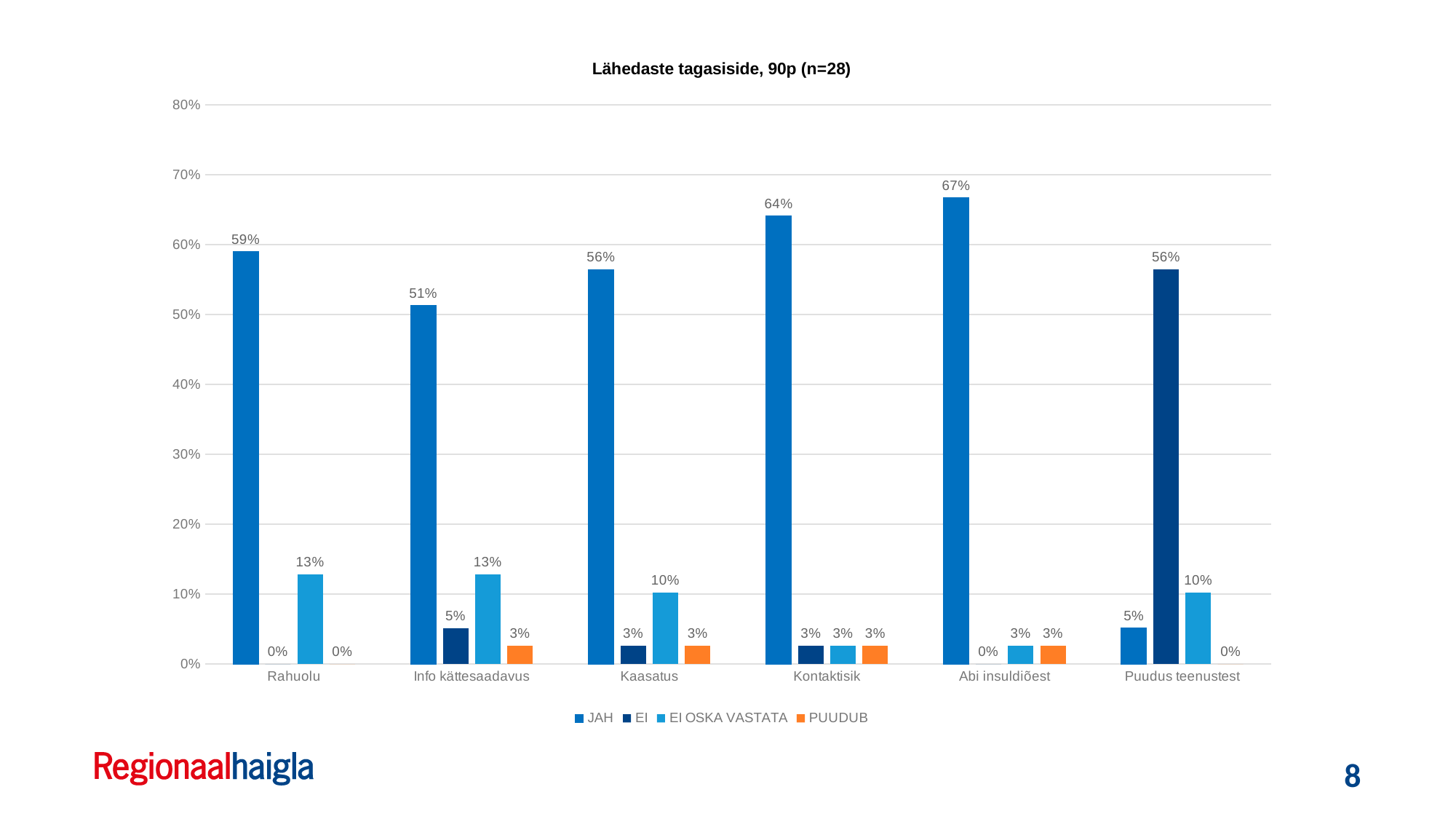
What is the title of the chart? Lähedaste tagasiside, 90p (n=28) What is the difference between the JAH values for Abi insuldiõest and Info kättesaadavus? 16% What kind of chart is shown on the slide? bar chart How many series does the legend list? 4 How many categories are shown on the x axis? 6 What is the JAH value for Kontaktisik? 64% What is the EI OSKA VASTATA value for Info kättesaadavus? 13% Which category has the lowest JAH value? Puudus teenustest Which is larger: the JAH value for Rahuolu or the JAH value for Kaasatus? Rahuolu Which category has the highest JAH value? Abi insuldiõest Is the JAH value for Kontaktisik greater or less than 60%? greater What is the EI value for Puudus teenustest? 56%